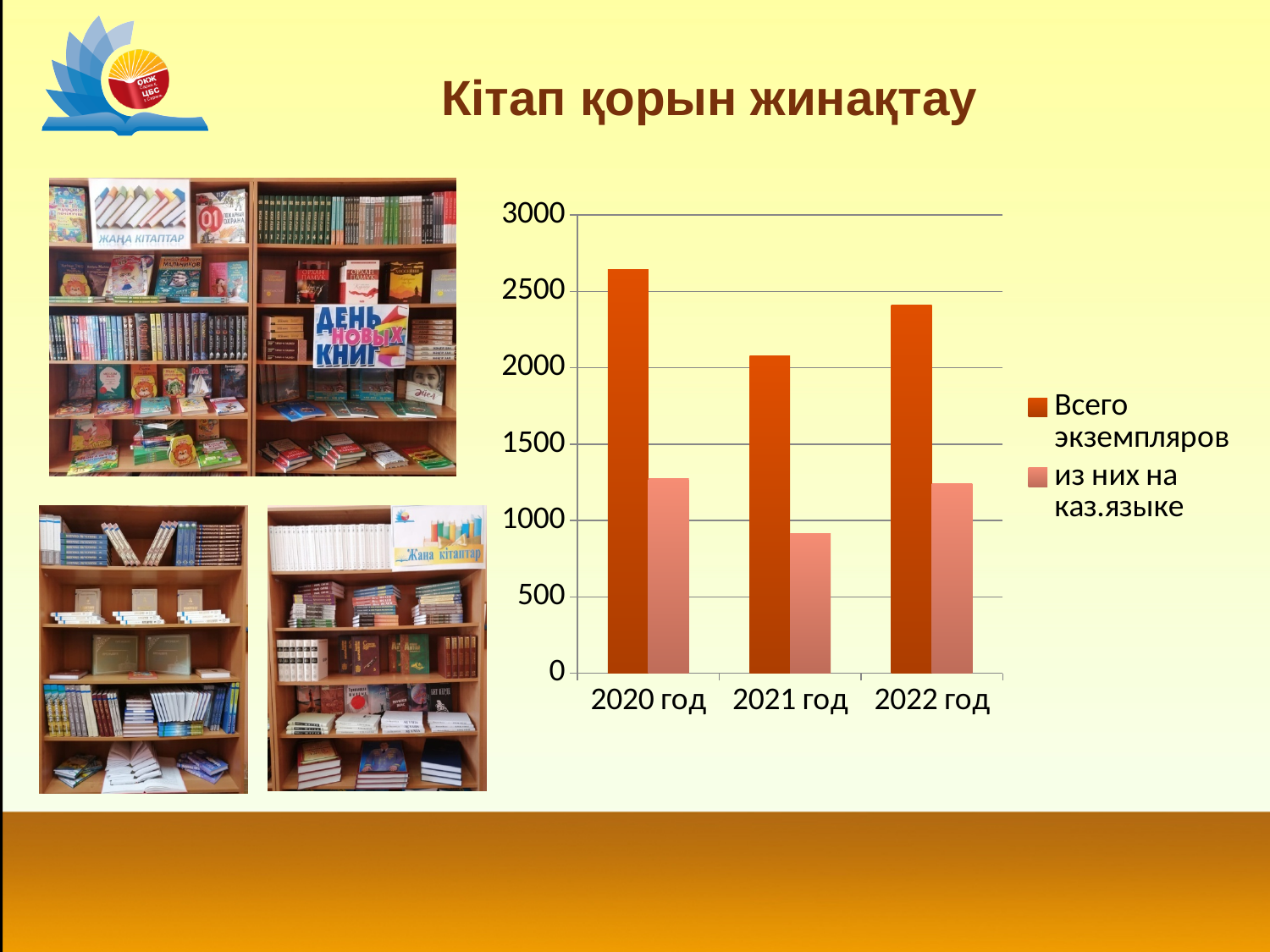
Which year has the lowest value for из них на каз.языке? 2021 год Is the value for из них на каз.языке in 2020 год greater or less than 1000? greater How many series does the chart legend list? 2 Which year has the highest value for Всего экземпляров? 2020 год Which is larger: Всего экземпляров in 2020 год or in 2022 год? 2020 год How many year categories are shown on the x axis of the chart? 3 Is the value for Всего экземпляров in 2022 год greater or less than 2500? less Is the value for из них на каз.языке in 2021 год greater or less than 1000? less What kind of chart is shown on the slide? bar chart Does the value for Всего экземпляров rise or fall from 2020 год to 2021 год? fall Which year has the lowest value for Всего экземпляров? 2021 год